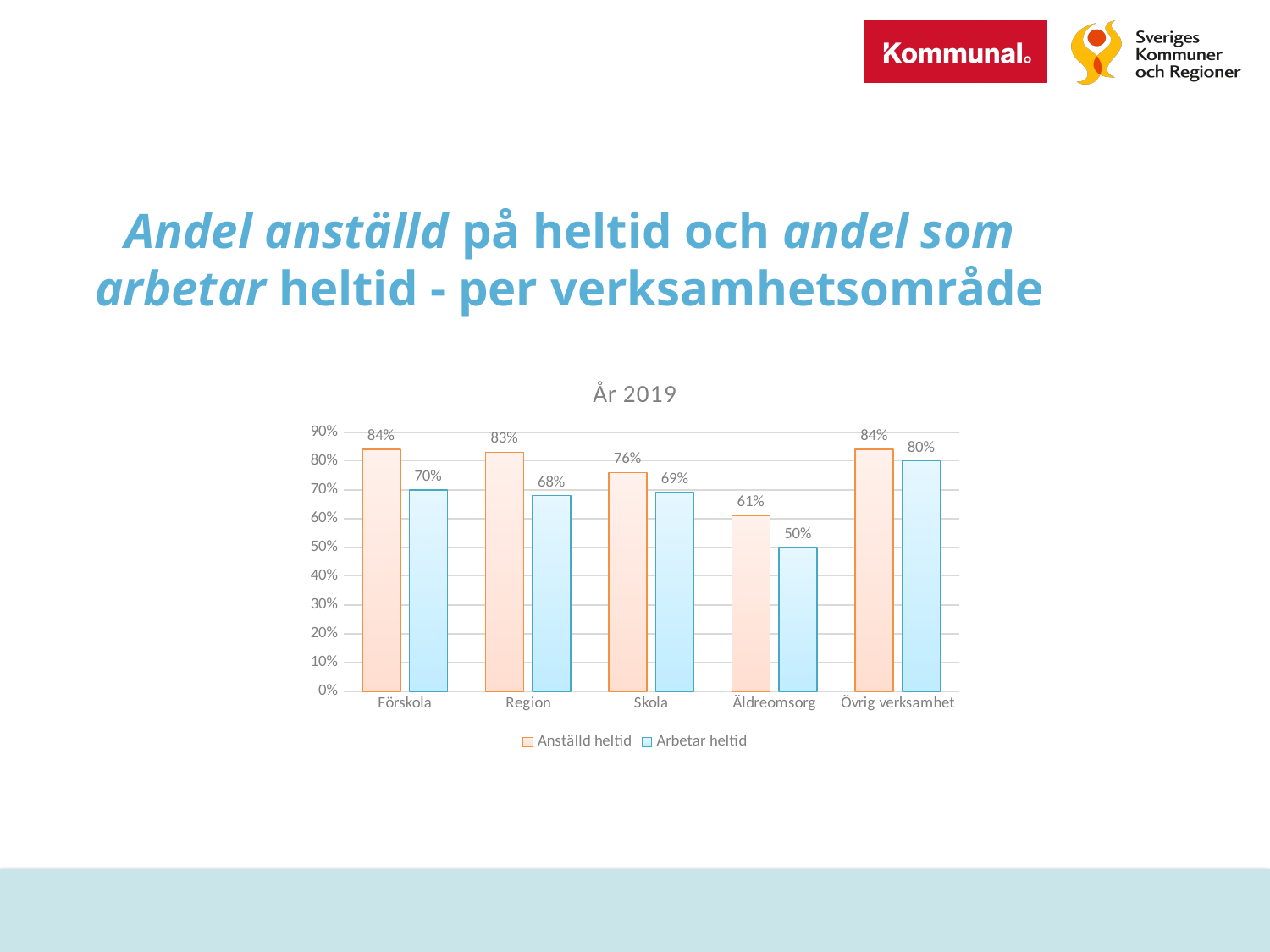
What kind of chart is shown on the slide? Bar chart What is the difference between Anställd heltid and Arbetar heltid in Skola? 7 percentage points Which is larger: Arbetar heltid in Region or Arbetar heltid in Övrig verksamhet? Övrig verksamhet How many series does the legend list? 2 What is the difference between Anställd heltid and Arbetar heltid in Äldreomsorg? 11 percentage points What is the value for Arbetar heltid in Övrig verksamhet? 80% What is the title of the chart? År 2019 What is the value for Arbetar heltid in Äldreomsorg? 50% How many categories are shown on the x axis? 5 What is the value for Anställd heltid in Förskola? 84% Which category has the lowest value for Anställd heltid? Äldreomsorg Which category has the lowest value for Arbetar heltid? Äldreomsorg